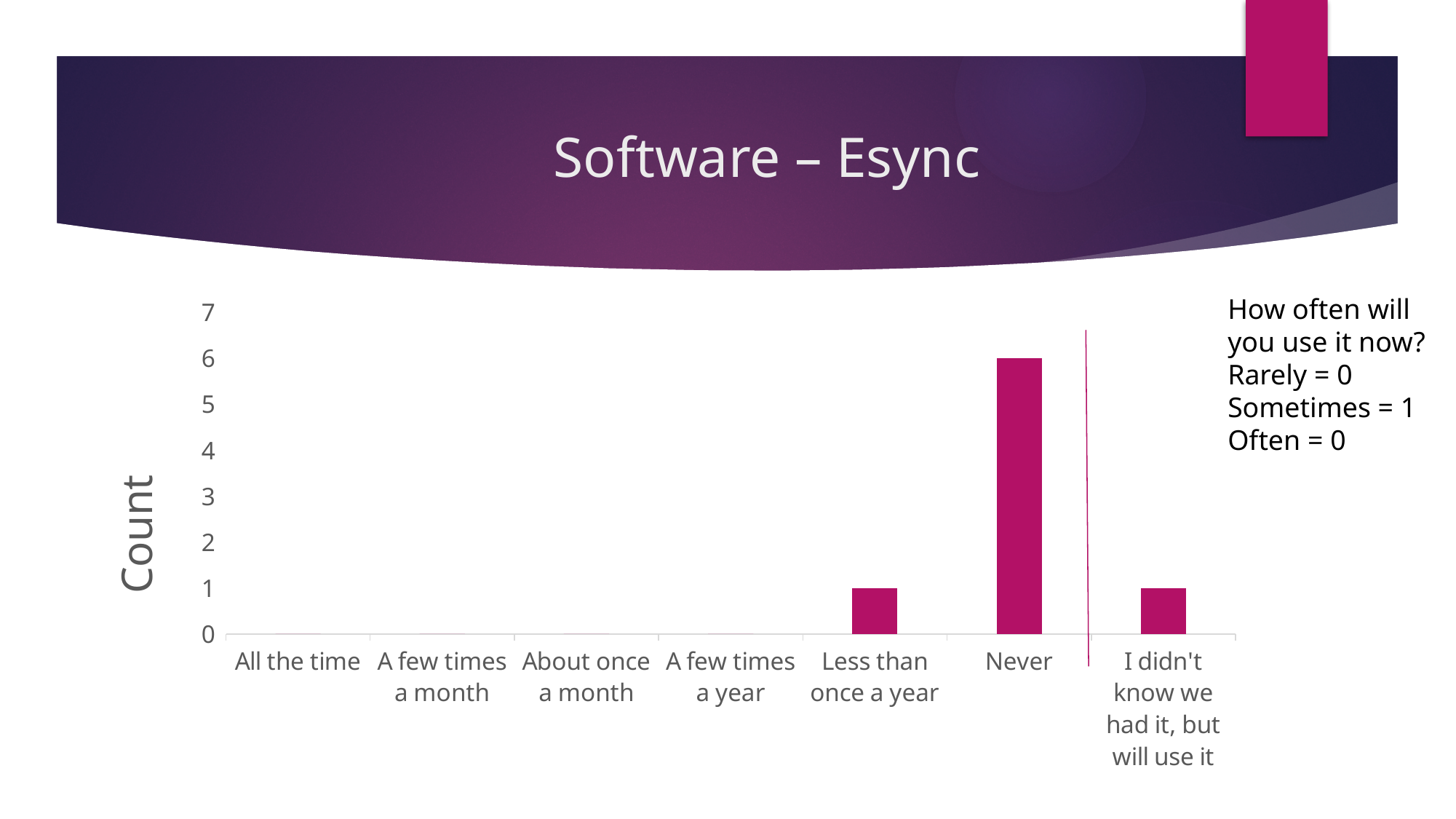
What is the label on the vertical axis? Count Is the count for "Never" greater or less than 5? greater What is the count for "All the time"? 0 Which is larger, the count for "Never" or the count for "A few times a year"? Never What is the difference between the count for "Never" and the count for "Less than once a year"? 5 What is the title of the slide containing the chart? Software – Esync What is the count for "I didn't know we had it, but will use it"? 1 What kind of chart is shown on the slide? Bar chart What is the count for the "Never" category? 6 How many categories are shown on the x axis? 7 What is the count for "Less than once a year"? 1 Which category has the highest count? Never